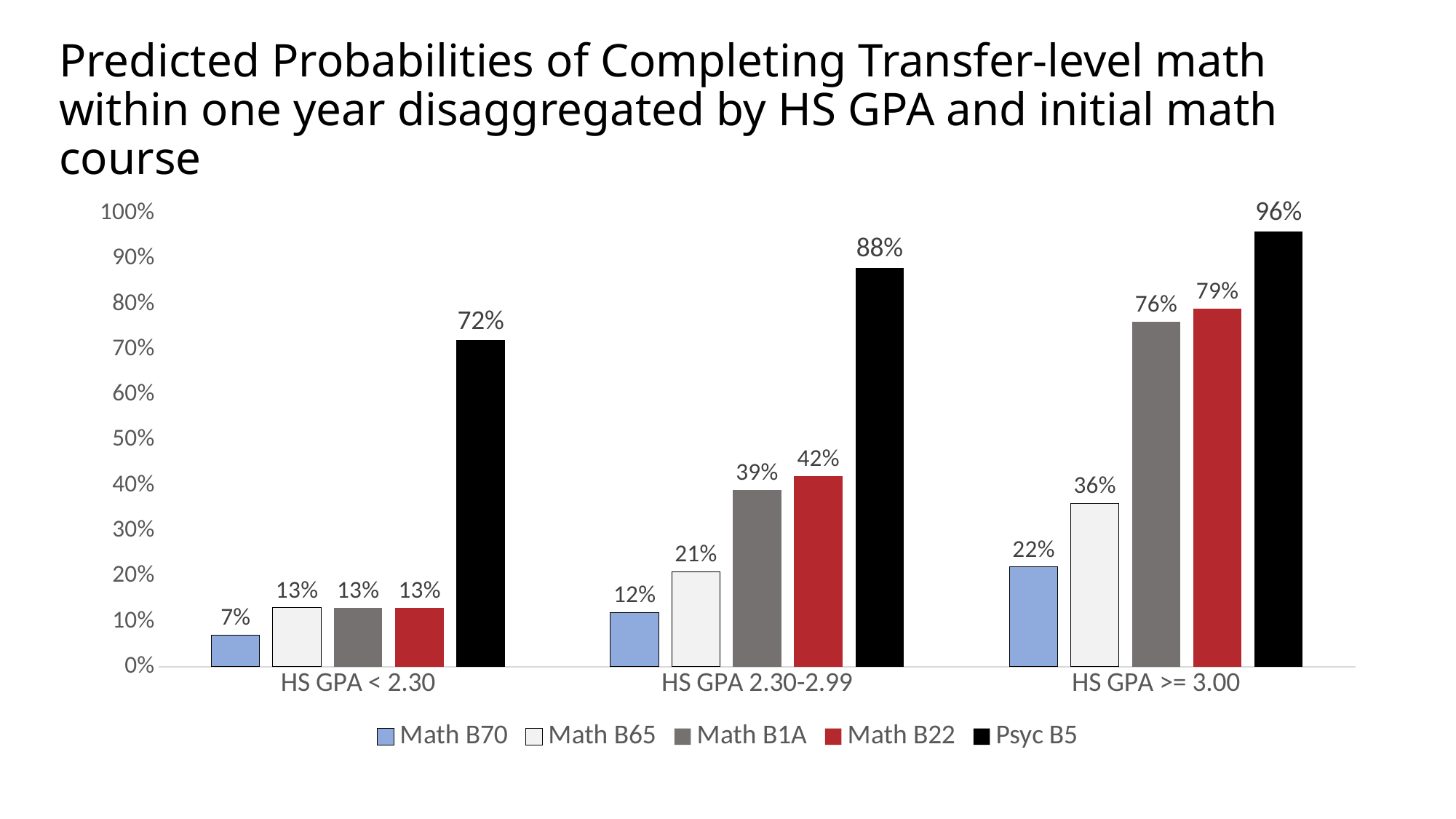
What is the difference between the Psyc B5 values for HS GPA >= 3.00 and HS GPA < 2.30? 24% What is the value for Psyc B5 in the HS GPA < 2.30 group? 72% What is the value for Math B70 in the HS GPA >= 3.00 group? 22% Do the Math B65 values rise or fall as HS GPA increases across the x axis? Rise What is the value for Math B1A in the HS GPA 2.30-2.99 group? 39% Which colour represents the Psyc B5 series in the legend? Black How many HS GPA categories are shown on the x axis? 3 Which is larger: Math B22 in the HS GPA 2.30-2.99 group or Math B65 in the HS GPA >= 3.00 group? Math B22 in the HS GPA 2.30-2.99 group Which series has the highest value in the HS GPA >= 3.00 group? Psyc B5 How many series does the legend list? 5 What kind of chart is shown on the slide? Bar chart Which series has the lowest value in the HS GPA < 2.30 group? Math B70